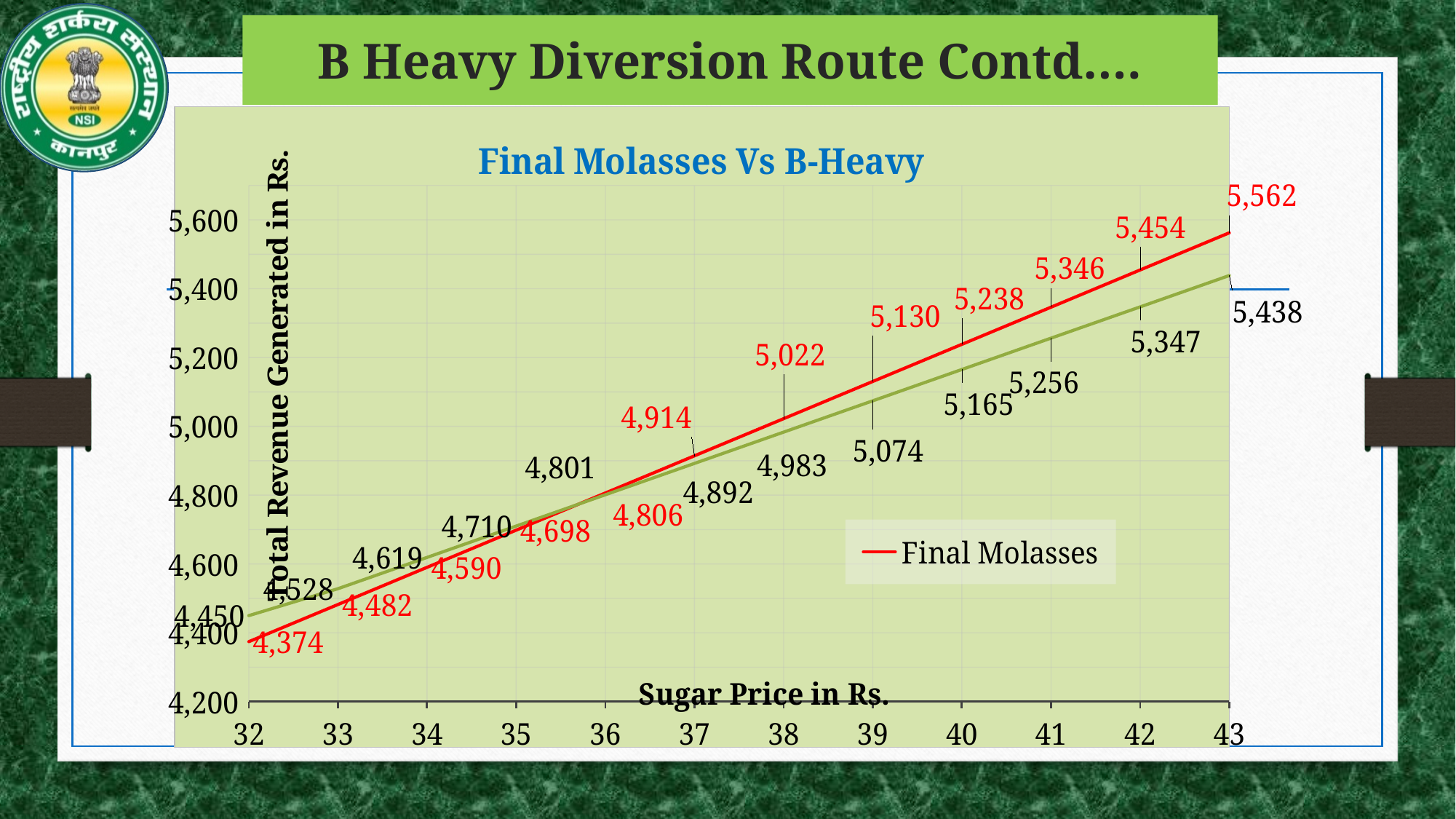
At a sugar price of 43, which is larger: the Final Molasses value or the green line value? Final Molasses What is the Final Molasses revenue at a sugar price of 43? 5,562 What kind of chart is shown on the slide? line chart At which sugar price is the Final Molasses revenue highest? 43 At a sugar price of 32, which is larger: the Final Molasses value or the green line value? the green line Do the Final Molasses values rise or fall as the sugar price increases? rise What is the Final Molasses revenue at a sugar price of 32? 4,374 What is the title of the x axis? Sugar Price in Rs. How many sugar price points are plotted on the x axis? 12 What is the value of the green line at a sugar price of 43? 5,438 At which sugar price is the Final Molasses revenue lowest? 32 What is the difference between the Final Molasses revenue at sugar price 43 and at sugar price 32? 1,188